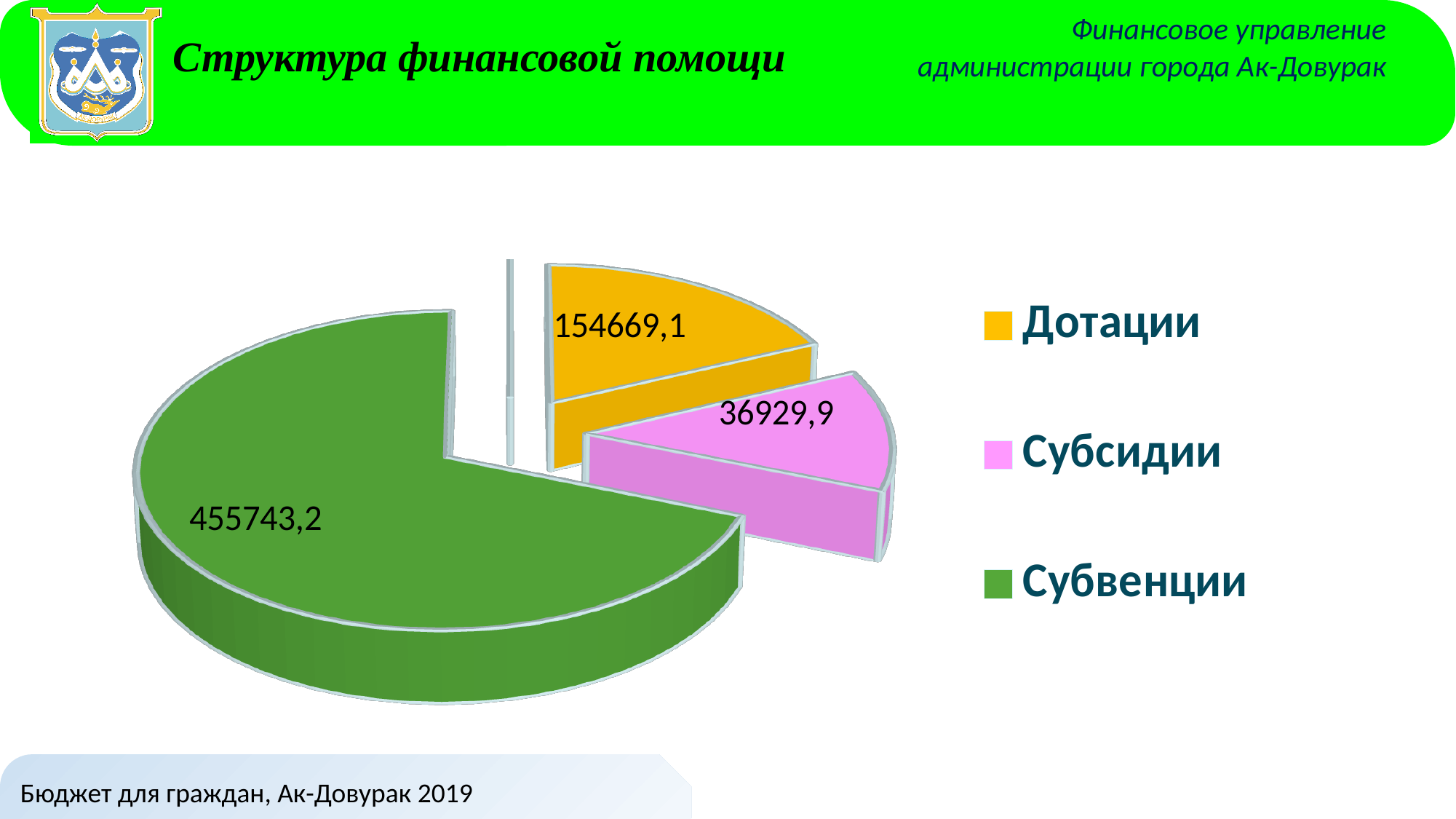
Which is larger, Дотации or Субсидии? Дотации Which category has the largest slice of the pie? Субвенции What is the title of the chart on the slide? Структура финансовой помощи What colour is the slice for Субвенции? Green Which category has the smallest slice of the pie? Субсидии What is the value for Субвенции? 455743,2 What is the difference between the values for Дотации and Субсидии? 117739,2 How many categories does the pie chart have? 3 What is the value for Субсидии? 36929,9 What kind of chart is shown on the slide? Pie chart What is the value for Дотации? 154669,1 What is the difference between the values for Субвенции and Дотации? 301074,1